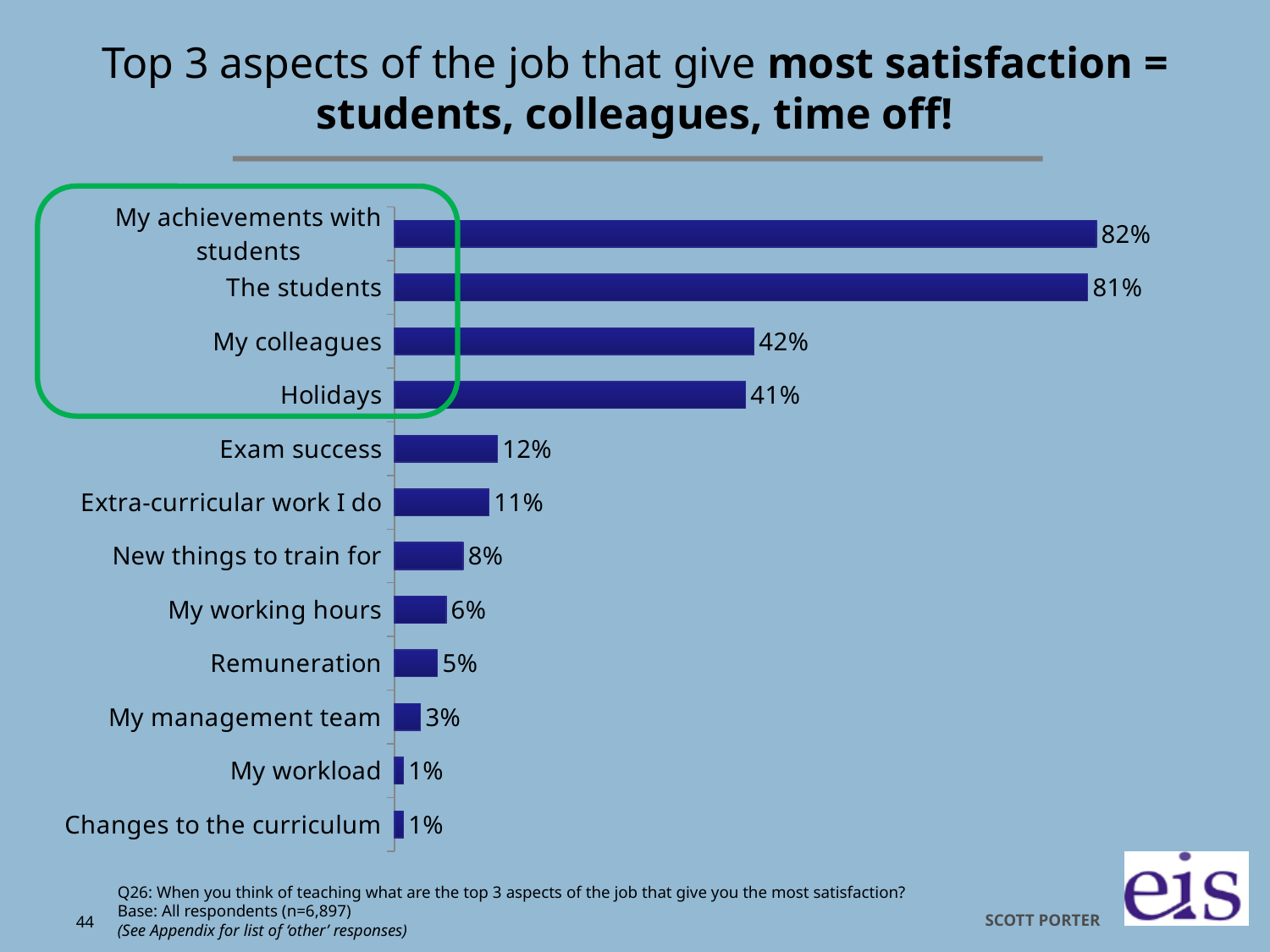
What is the value shown for 'Holidays'? 41% What percentage of respondents chose 'My colleagues' as a top 3 aspect giving most satisfaction? 42% How many categories are enclosed by the green outline on the chart? 4 How many categories are shown in the chart? 12 What kind of chart is shown on the slide? Bar chart What is the value shown for 'Exam success'? 12% Which aspect has the highest value in the chart? My achievements with students What is the difference between the values for 'My achievements with students' and 'The students'? 1% Which two categories share the lowest value of 1%? My workload and Changes to the curriculum What is the value shown for 'Remuneration'? 5% Which is larger, the value for 'Extra-curricular work I do' or the value for 'New things to train for'? Extra-curricular work I do What is the difference between the values for 'My colleagues' and 'Exam success'? 30%